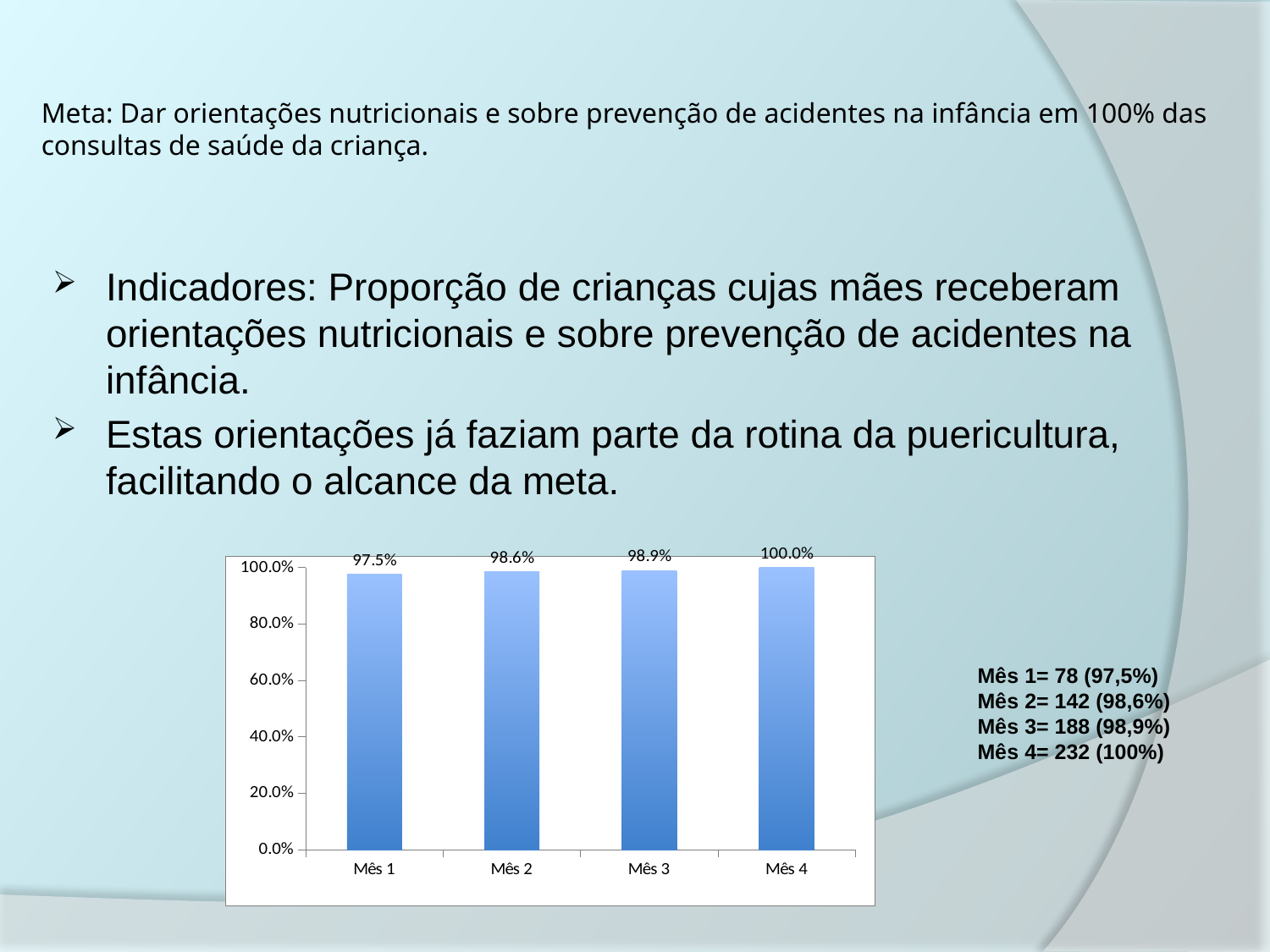
What is the value for Mês 1? 97.5% Is the value for Mês 1 greater or less than 80.0%? greater What is the value for Mês 2? 98.6% What kind of chart is shown on the slide? bar chart What is the value for Mês 4? 100.0% Which month has the highest value? Mês 4 Do the values rise or fall from Mês 1 to Mês 4? rise How many months are shown on the x axis? 4 What is the difference between the values for Mês 4 and Mês 1? 2.5% Which is larger, the value for Mês 2 or the value for Mês 3? Mês 3 What is the value for Mês 3? 98.9% Which month has the lowest value? Mês 1